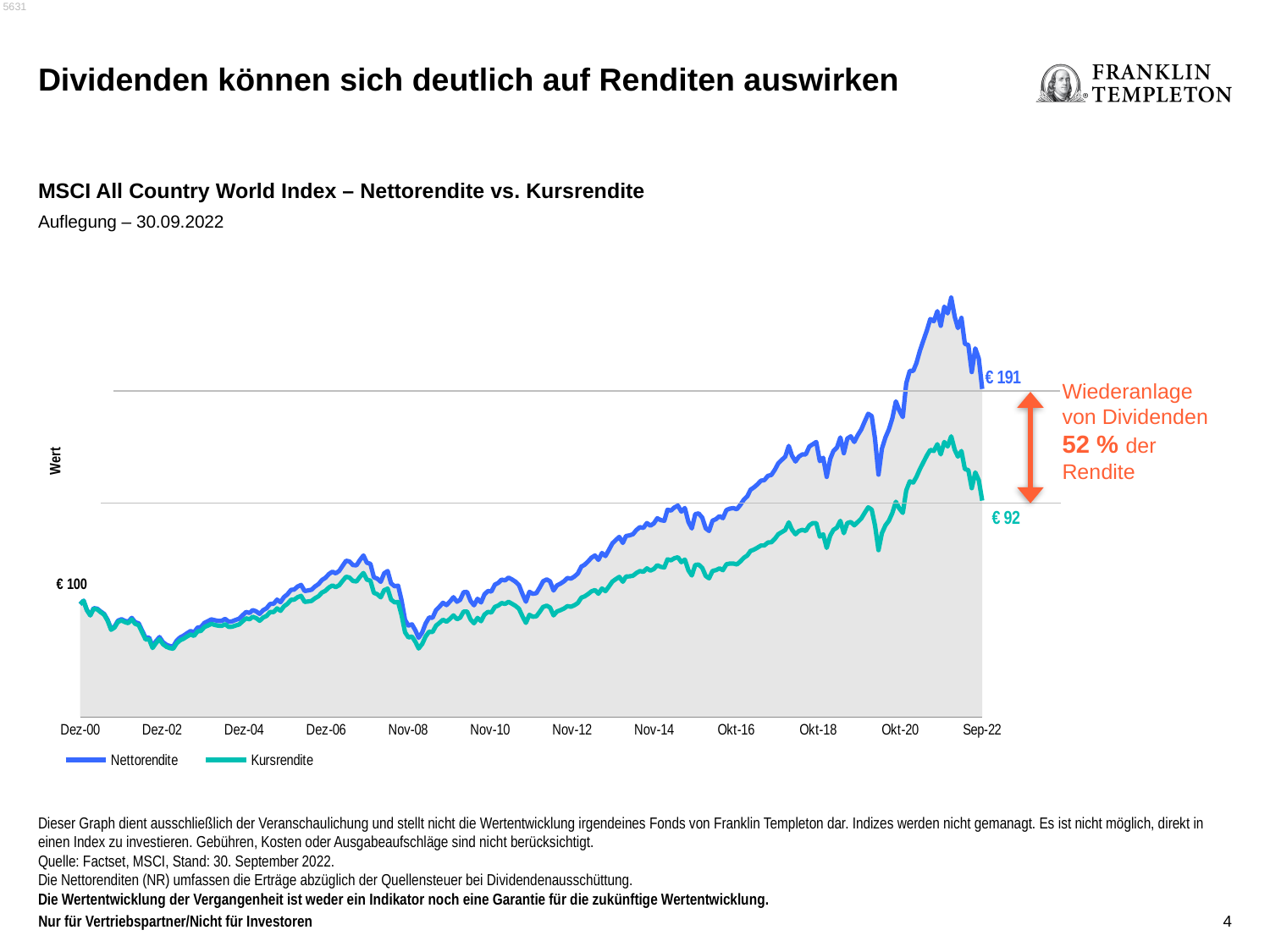
What is the value of the Kursrendite series at Sep-22? € 92 Which series has the higher value at Sep-22, Nettorendite or Kursrendite? Nettorendite What is the difference between the Nettorendite and Kursrendite values at Sep-22? € 99 What is the value of the Nettorendite series at Sep-22? € 191 According to the annotation, what share of the return is attributed to reinvestment of dividends (Wiederanlage von Dividenden)? 52 % Does the Nettorendite series overall rise or fall from Dez-00 to Sep-22? Rise What are the two series named in the legend? Nettorendite and Kursrendite What kind of chart is shown on the slide? Line chart What starting value is labelled at the beginning of the chart (Dez-00)? € 100 How many date labels are shown on the x axis? 12 How many series does the legend list? 2